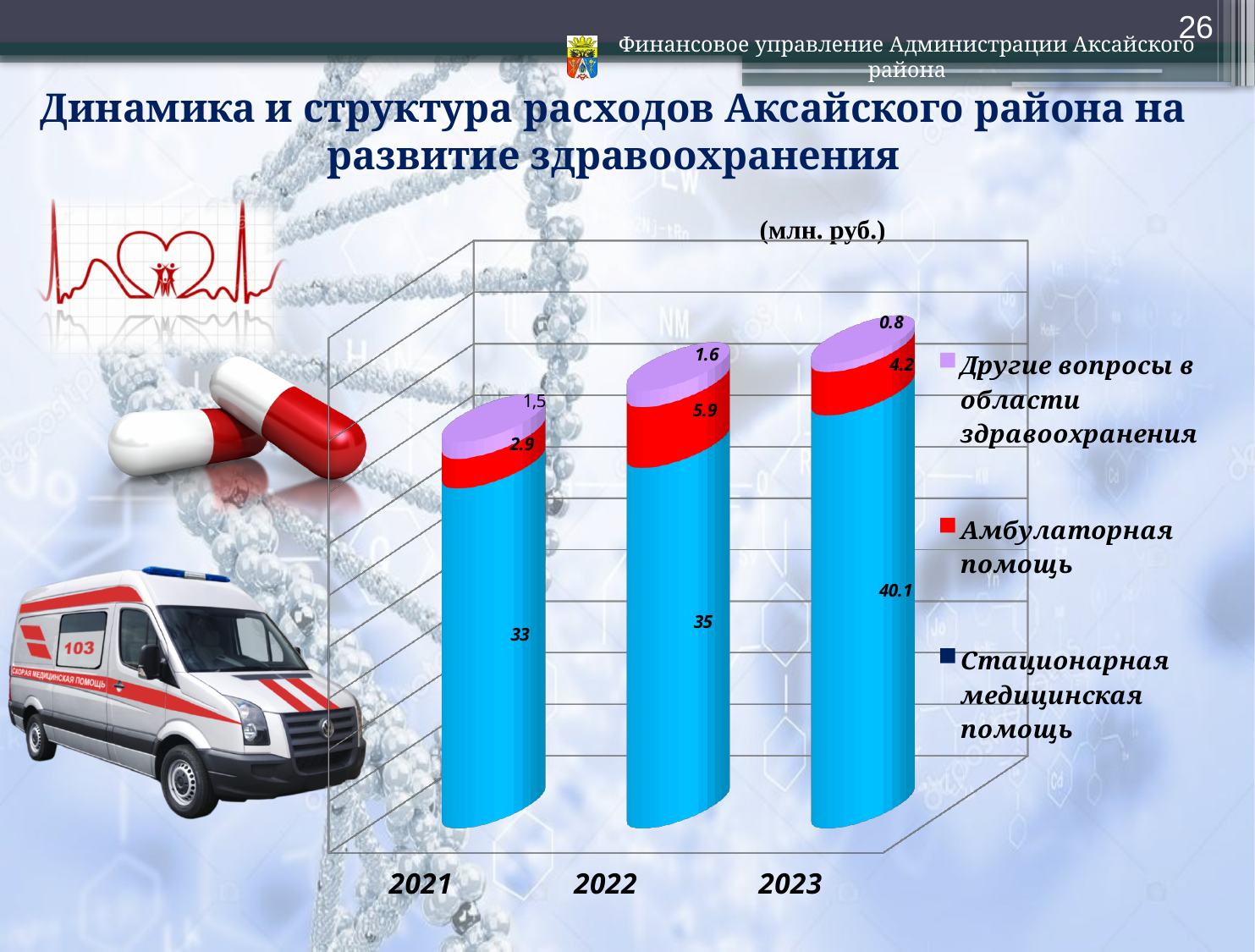
What is the total of the stacked bar for 2022? 42.5 What kind of chart is shown on the slide? Stacked bar chart What is the difference between the Стационарная медицинская помощь values for 2023 and 2022? 5.1 What is the value for Стационарная медицинская помощь in 2021? 33 In which year is the value for Амбулаторная помощь the highest? 2022 In which year is the value for Другие вопросы в области здравоохранения the lowest? 2023 Which is larger: Амбулаторная помощь in 2023 or in 2021? 2023 How many series does the legend list? 3 How many years are shown on the x axis? 3 What is the value for Стационарная медицинская помощь in 2023? 40.1 What is the value for Другие вопросы в области здравоохранения in 2021? 1,5 What is the value for Амбулаторная помощь in 2022? 5.9